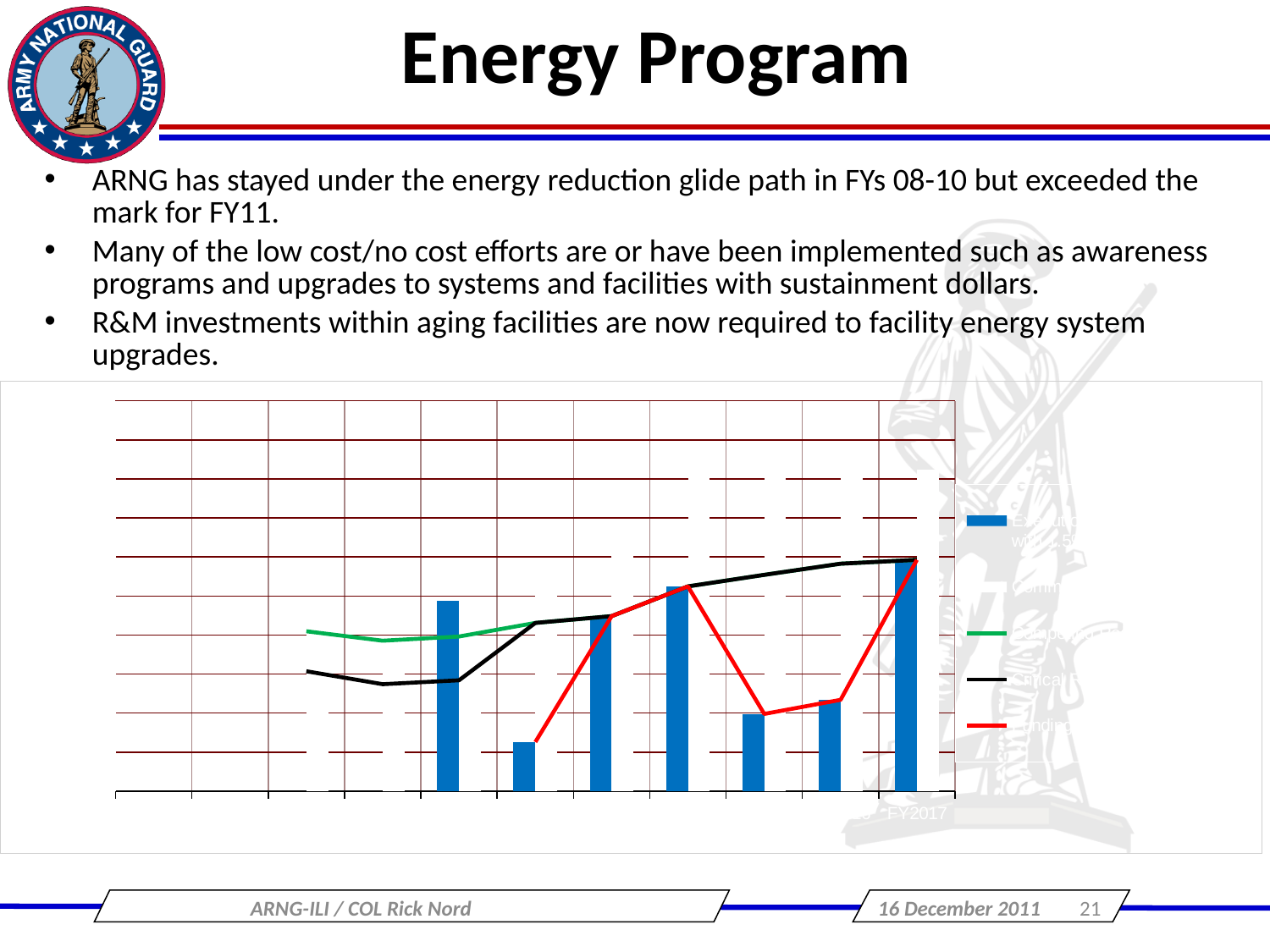
How many bars are plotted in the chart? 7 What kind of chart is shown on the slide? A bar chart combined with line series Which bar is the tallest in the chart, counting from the left? The seventh (rightmost) bar Is the first bar from the left taller or shorter than the second bar? Taller What colour are the bars in the chart? Blue Does the black line generally rise or fall from left to right? Rise What colours are the three lines plotted in the chart? Green, black and red Which bar is the shortest in the chart, counting from the left? The second bar How many line series are plotted in the chart? 3